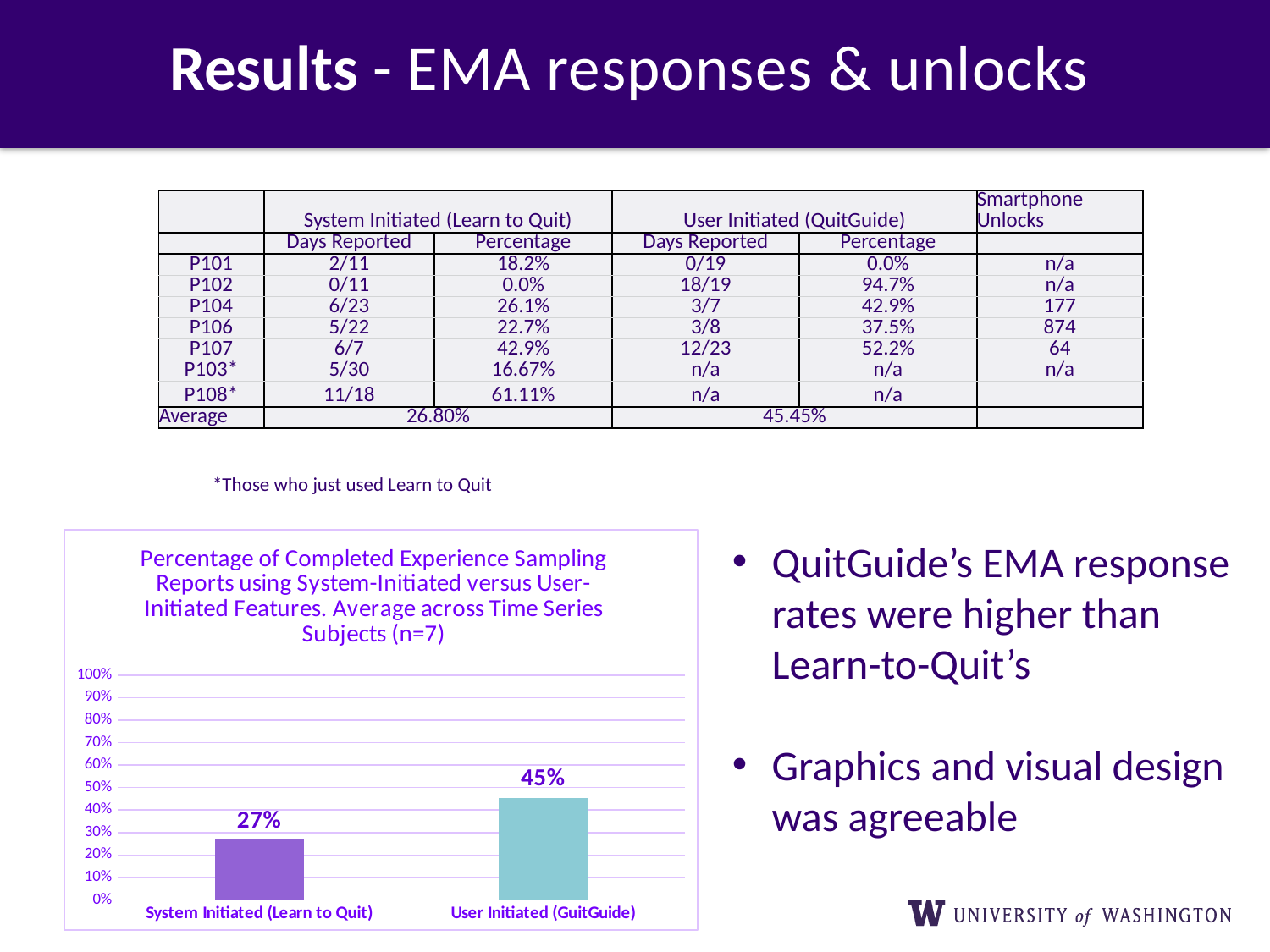
Which is larger in the bar chart: System Initiated (Learn to Quit) or User Initiated (GuitGuide)? User Initiated (GuitGuide) What is the difference between the User Initiated (GuitGuide) and System Initiated (Learn to Quit) values in the bar chart? 18% What kind of chart is shown on the slide? bar chart Is the value for System Initiated (Learn to Quit) greater or less than 20%? greater What is the maximum value shown on the y axis of the bar chart? 100% Which category has the lowest value in the bar chart? System Initiated (Learn to Quit) What is the title of the bar chart? Percentage of Completed Experience Sampling Reports using System-Initiated versus User-Initiated Features. Average across Time Series Subjects (n=7) What is the value for User Initiated (GuitGuide) in the bar chart? 45% How many categories are shown in the bar chart? 2 What is the value for System Initiated (Learn to Quit) in the bar chart? 27% Which category has the highest value in the bar chart? User Initiated (GuitGuide) Is the value for User Initiated (GuitGuide) greater or less than 50%? less